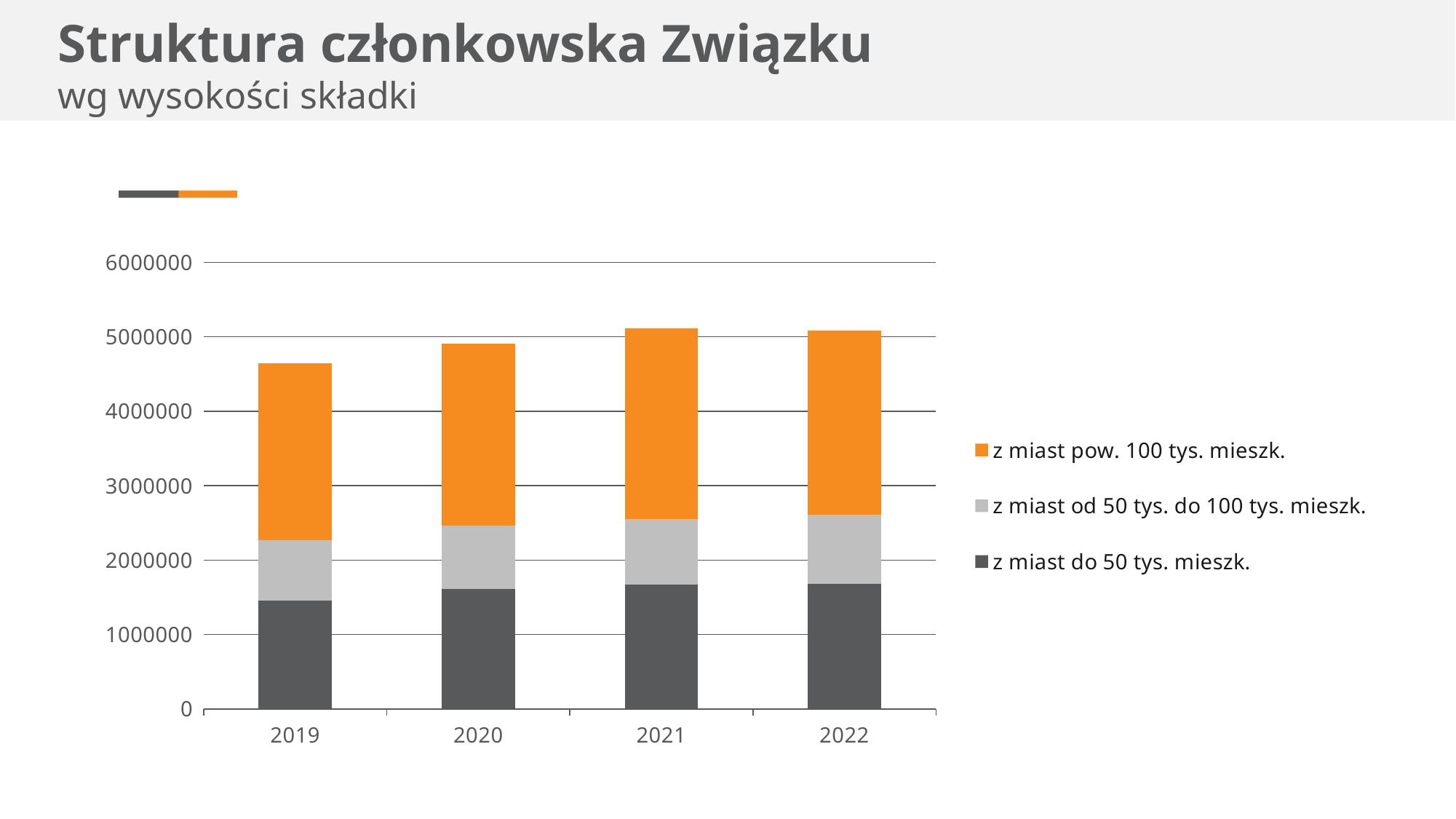
How many series does the chart legend list? 3 Which year has the lowest total bar height? 2019 Is the total bar for 2019 greater or less than 5000000? less Is the 'z miast do 50 tys. mieszk.' segment for 2019 greater or less than 2000000? less Is the total bar for 2021 greater or less than 5000000? greater Which year has the larger total bar, 2019 or 2020? 2020 How many years are shown on the x axis of the chart? 4 Which series is shown in orange in the chart legend? z miast pow. 100 tys. mieszk. What kind of chart is shown on the slide? stacked bar chart Does the total bar height rise or fall from 2019 to 2021? rise